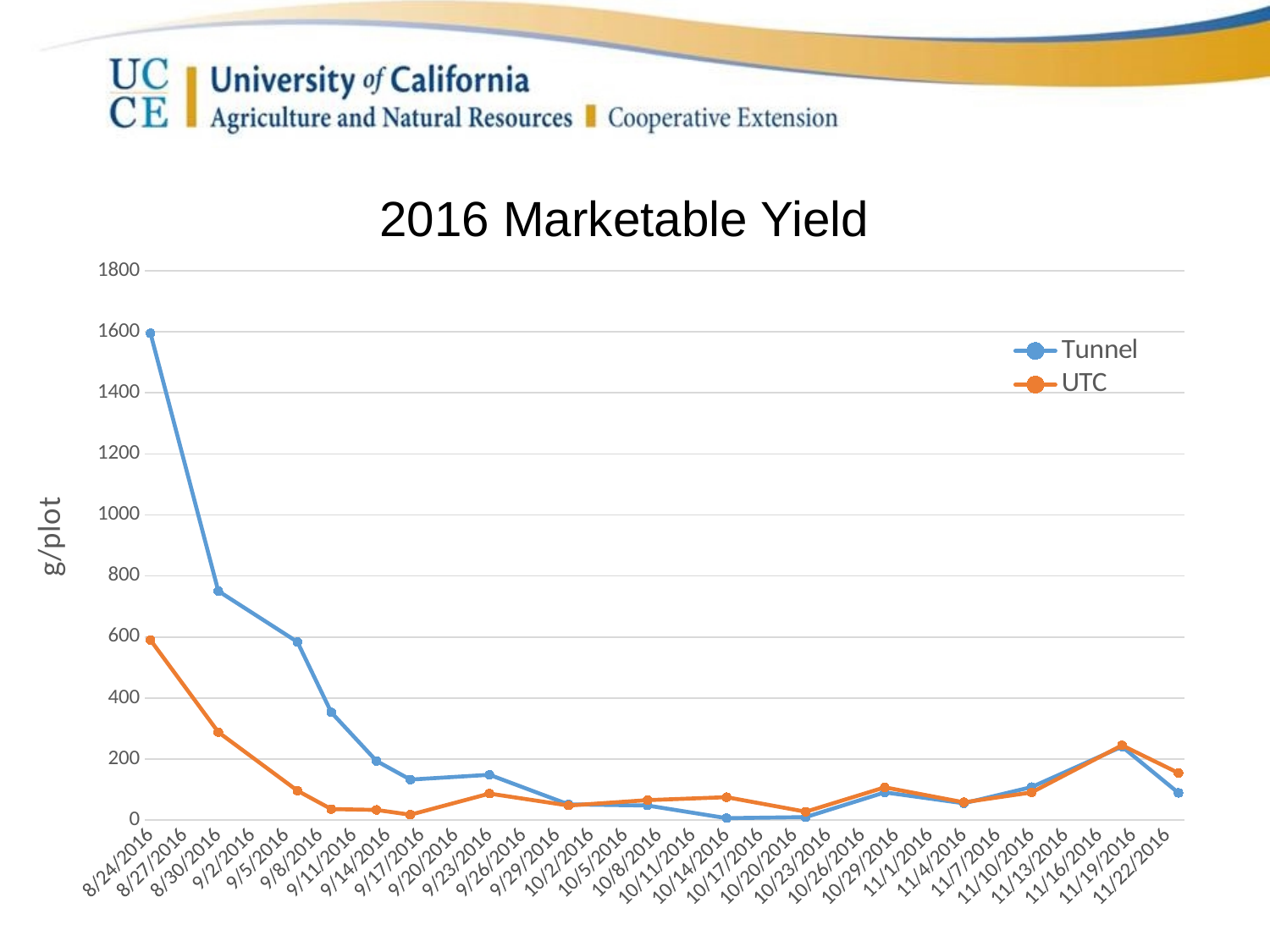
What kind of chart is shown on the slide? line chart On 8/30/2016, which series has the larger value, Tunnel or UTC? Tunnel Is the Tunnel value on 8/30/2016 greater or less than 600? greater Is the Tunnel value on 8/24/2016 greater or less than 1400? greater Does the Tunnel series rise or fall between 8/24/2016 and 9/14/2016? fall What is the label on the y axis? g/plot On which date does the UTC series reach its highest value? 8/24/2016 On 11/22/2016, which series has the larger value, Tunnel or UTC? UTC How many series does the legend list? 2 On which date does the Tunnel series reach its highest value? 8/24/2016 What are the two series named in the legend? Tunnel and UTC Is the UTC value on 8/24/2016 greater or less than 400? greater